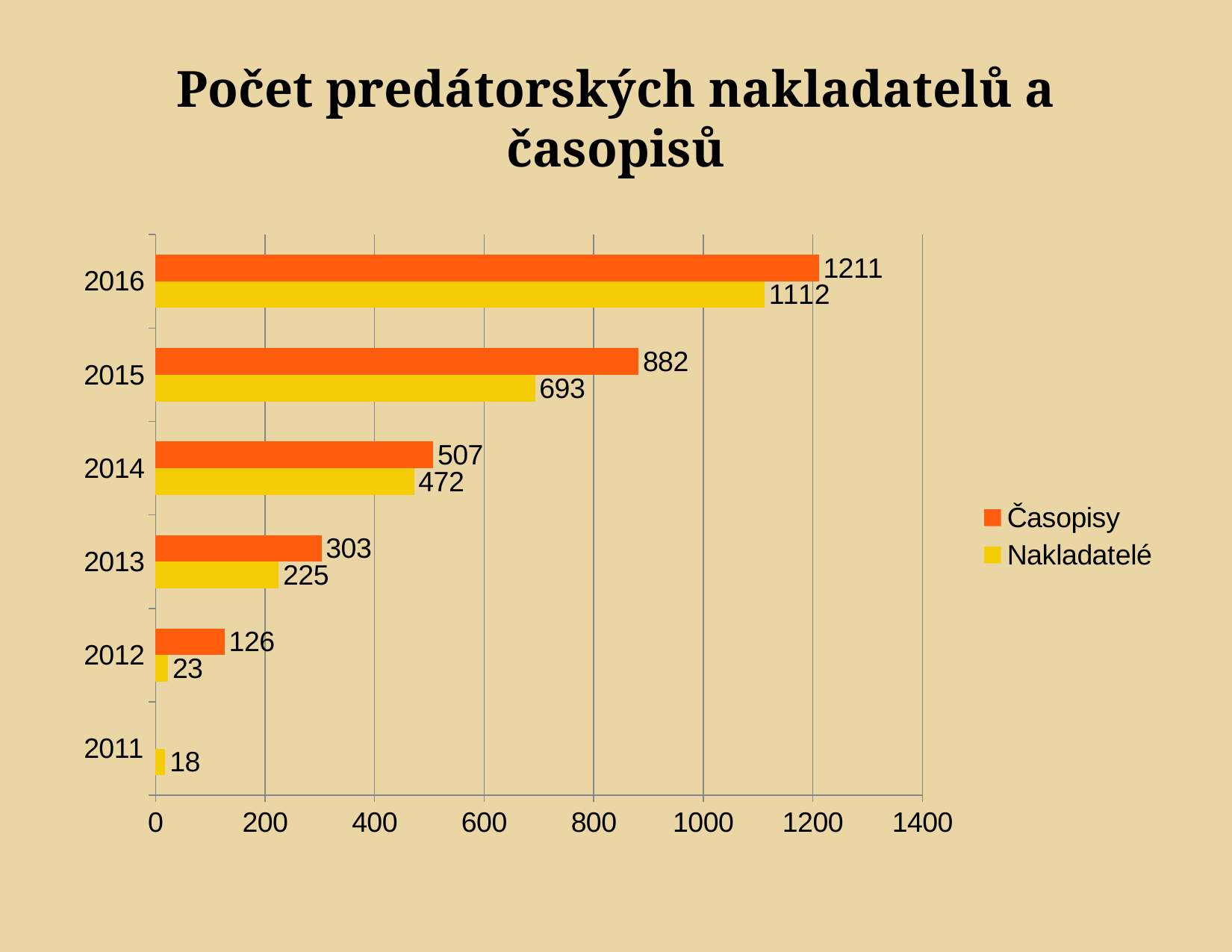
What colour represents Nakladatelé in the legend? yellow Is the value for Časopisy in 2015 greater or less than 800? greater What is the value for Nakladatelé in 2011? 18 What kind of chart is shown on the slide? bar chart Which year has the highest value for Nakladatelé? 2016 What is the value for Nakladatelé in 2015? 693 What is the value for Časopisy in 2016? 1211 What is the difference between Časopisy and Nakladatelé in 2014? 35 How many series does the legend list? 2 Which year has the lowest value for Časopisy among the years where it is shown? 2012 Which is larger in 2013, Časopisy or Nakladatelé? Časopisy How many years are shown on the chart? 6